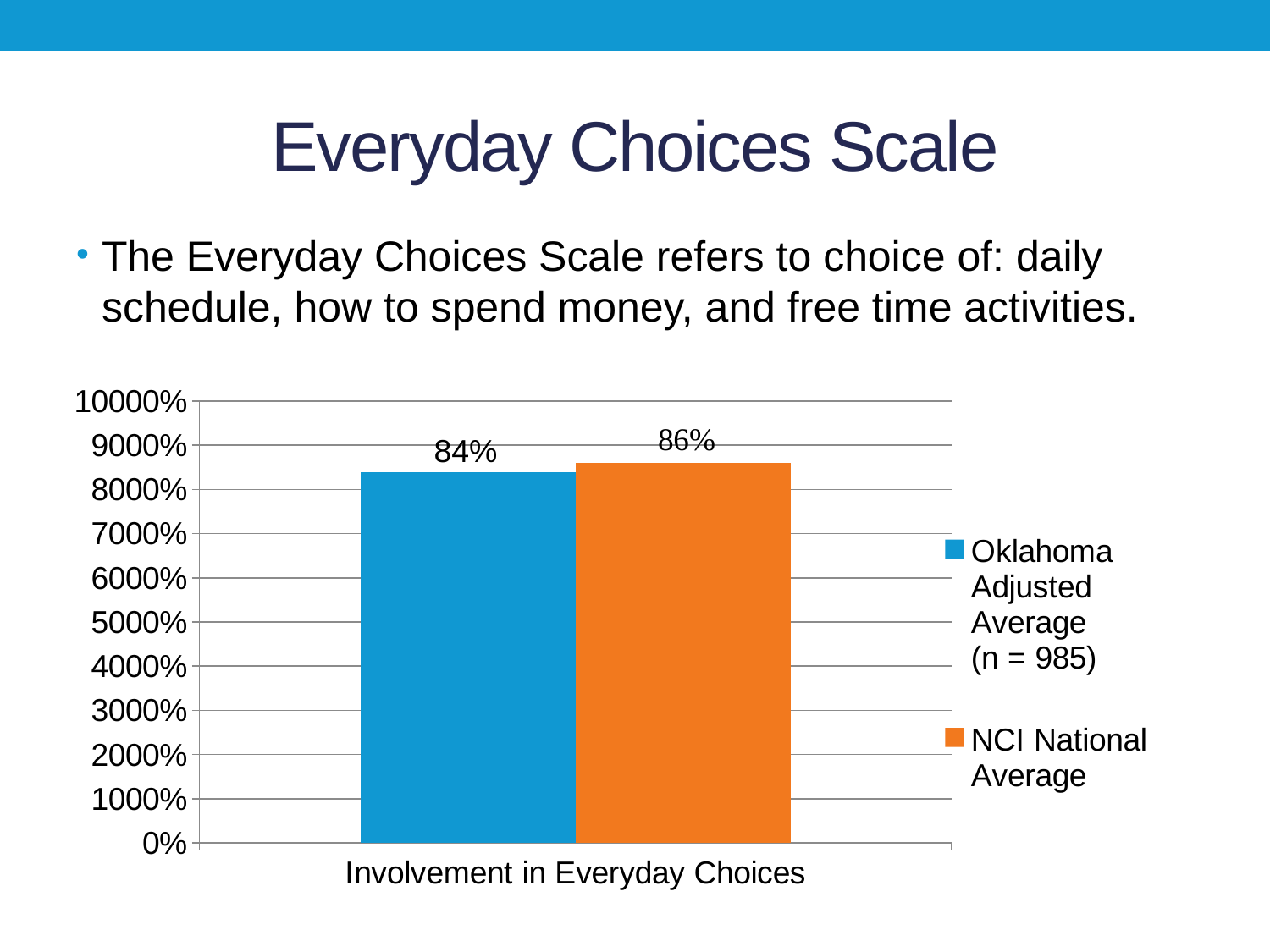
What is the value for the NCI National Average series for Involvement in Everyday Choices? 86% What is the difference between the NCI National Average value and the Oklahoma Adjusted Average (n = 985) value? 2% Which series has the lowest value in the chart? Oklahoma Adjusted Average (n = 985) What colour is the bar for the NCI National Average series? Orange How many categories are shown on the x axis of the chart? 1 What is the category label shown on the x axis of the chart? Involvement in Everyday Choices How many series does the legend list? 2 Which series has the higher value for Involvement in Everyday Choices, Oklahoma Adjusted Average (n = 985) or NCI National Average? NCI National Average What is the value for the Oklahoma Adjusted Average (n = 985) series for Involvement in Everyday Choices? 84% Which series has the highest value in the chart? NCI National Average What kind of chart is shown on the slide? Bar chart